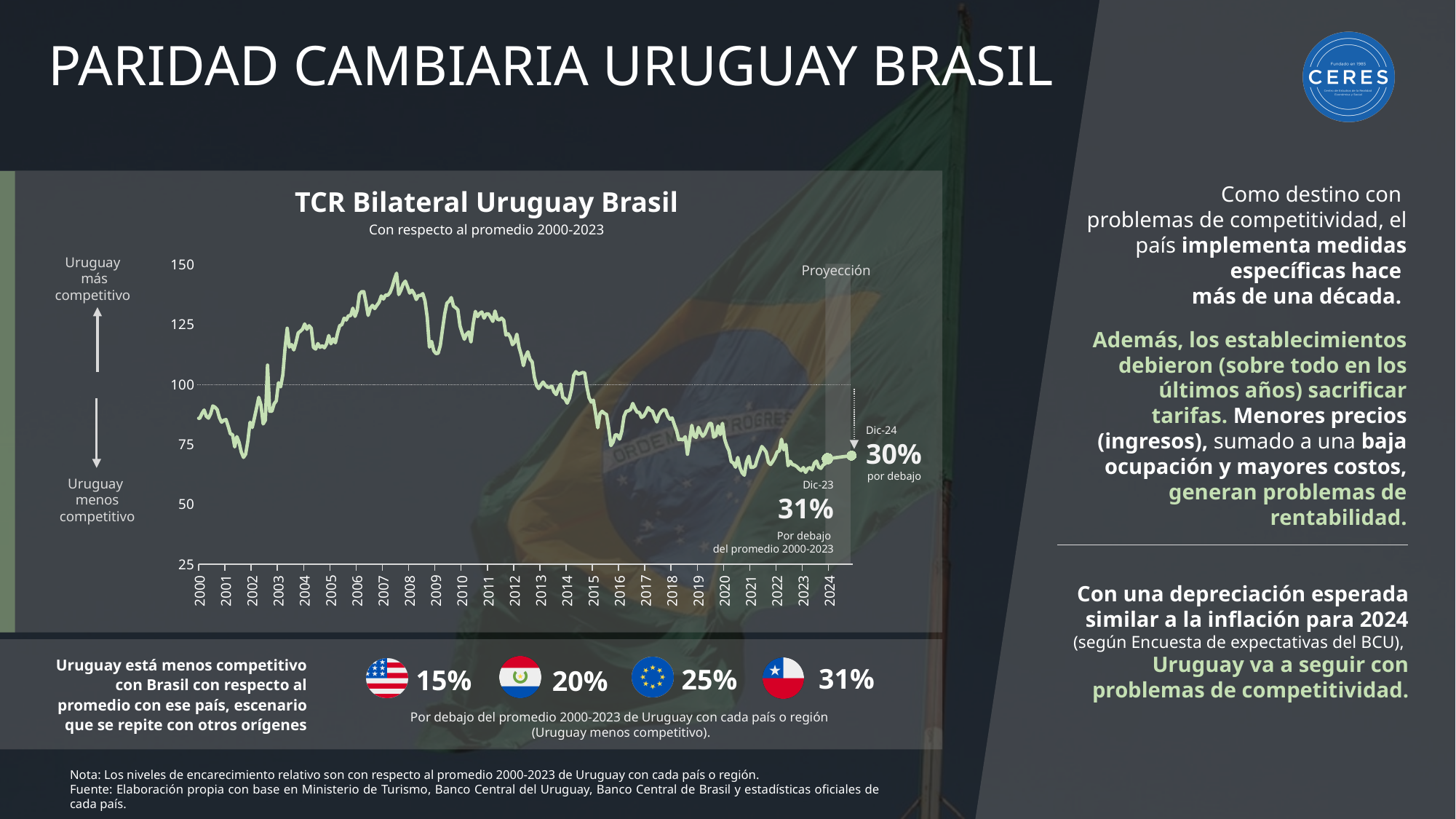
Between 2015 and 2021, does the line generally rise or fall? Fall Is the value of the line around 2021 greater or less than 75? less Is the value of the line at 2000 greater or less than 100? less Which is larger, the percentage below average shown for Dic-23 or for Dic-24? Dic-23 Is the value of the line around 2007 greater or less than 125? greater According to the chart's label, by what percentage is the TCR projected to be below the average in Dic-24? 30% What is the highest value shown on the chart's vertical axis? 150 What is the title of the chart? TCR Bilateral Uruguay Brasil What is the difference in percentage points between the Dic-23 value (31%) and the Dic-24 value (30%) shown on the chart? 1 percentage point What does the shaded area at the right end of the chart represent, according to its label? Proyección According to the chart's label, by what percentage was the TCR below the 2000-2023 average in Dic-23? 31% What kind of chart is shown on the slide? Line chart